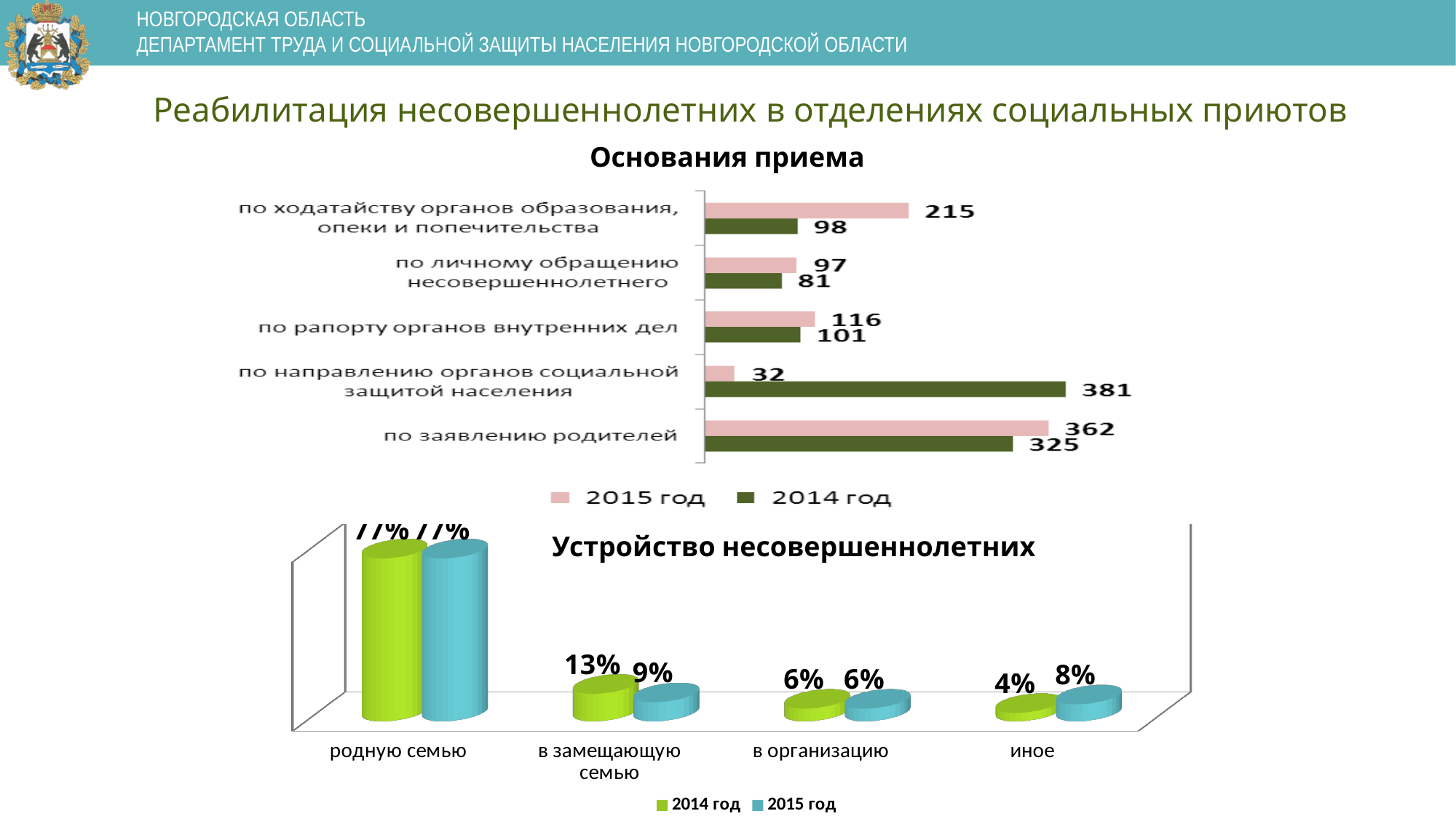
How many categories does the 'Основания приема' chart show? 5 In the 'Основания приема' chart, what is the 2015 value for 'по заявлению родителей'? 362 In the 'Устройство несовершеннолетних' chart, what is the 2014 value for 'в замещающую семью'? 13% In the 'Основания приема' chart, which is larger for 'по личному обращению несовершеннолетнего': the 2015 value or the 2014 value? 2015 год How many series does the legend of the 'Основания приема' chart list? 2 In the 'Основания приема' chart, what is the 2014 value for 'по направлению органов социальной защитой населения'? 381 In the 'Устройство несовершеннолетних' chart, what is the 2015 value for 'иное'? 8% In the 'Основания приема' chart, which category has the lowest 2015 value? по направлению органов социальной защитой населения In the 'Основания приема' chart, what is the difference between the 2015 and 2014 values for 'по ходатайству органов образования, опеки и попечительства'? 117 In the 'Основания приема' chart, what is the 2015 value for 'по рапорту органов внутренних дел'? 116 In the 'Основания приема' chart, which category has the highest 2015 value? по заявлению родителей What kind of chart is 'Устройство несовершеннолетних'? bar chart